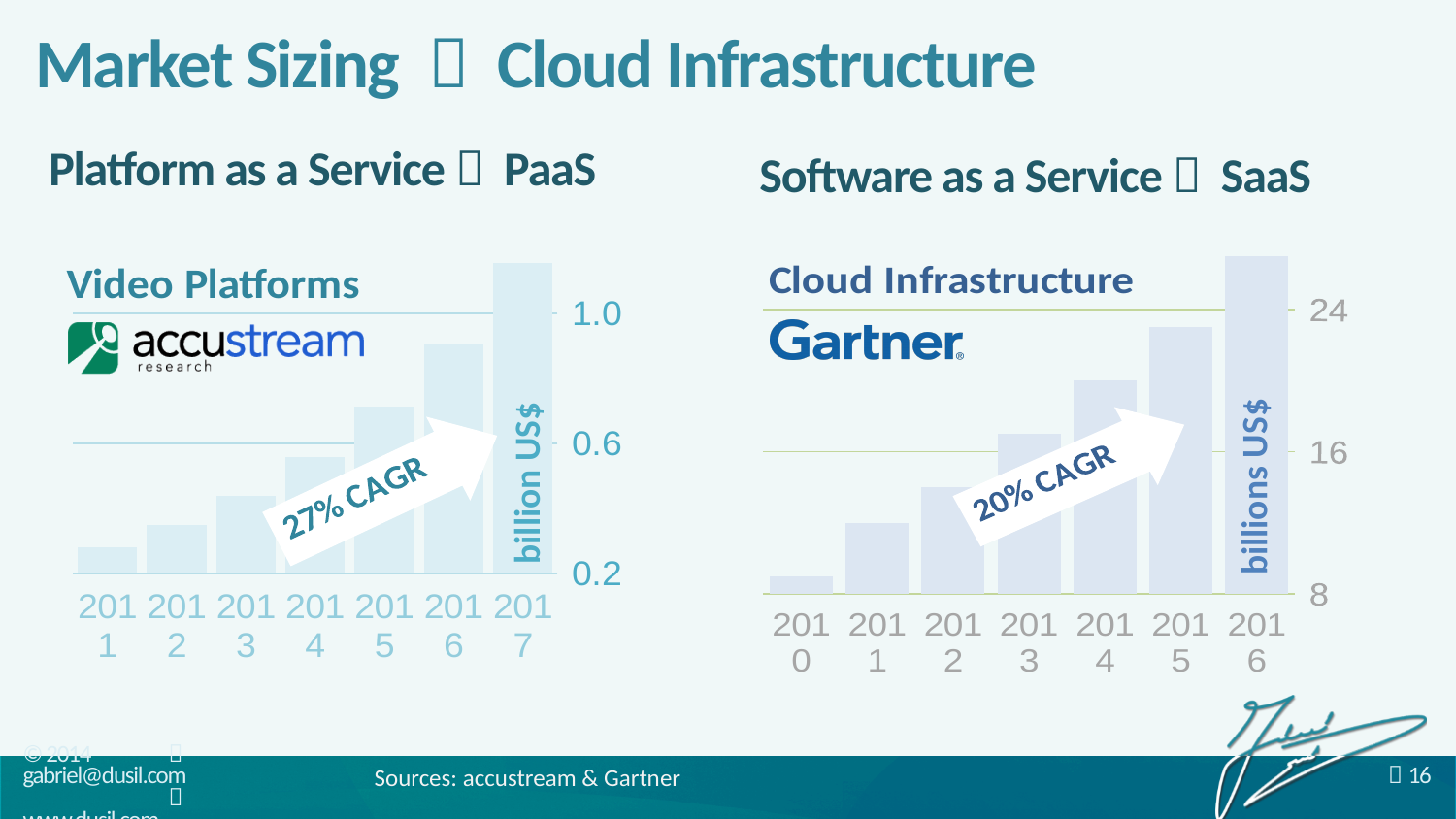
In the Video Platforms chart, which year has the lowest bar? 2011 In the Video Platforms chart, how many years are shown on the x axis? 7 In the Cloud Infrastructure chart, which year has the lowest bar? 2010 In the Video Platforms chart, do the values rise or fall from 2011 to 2017? rise What CAGR is printed on the Video Platforms chart? 27% CAGR In the Video Platforms chart, which year has the highest bar? 2017 In the Video Platforms chart, is the value for 2013 greater or less than 0.6? less In the Cloud Infrastructure chart, which is larger, the value for 2014 or the value for 2011? 2014 In the Cloud Infrastructure chart on the right, which year has the highest bar? 2016 In the Video Platforms chart, is the value for 2017 greater or less than 1.0? greater What type of chart is the Video Platforms chart on the left? bar chart In the Cloud Infrastructure chart, is the value for 2012 greater or less than 16? less